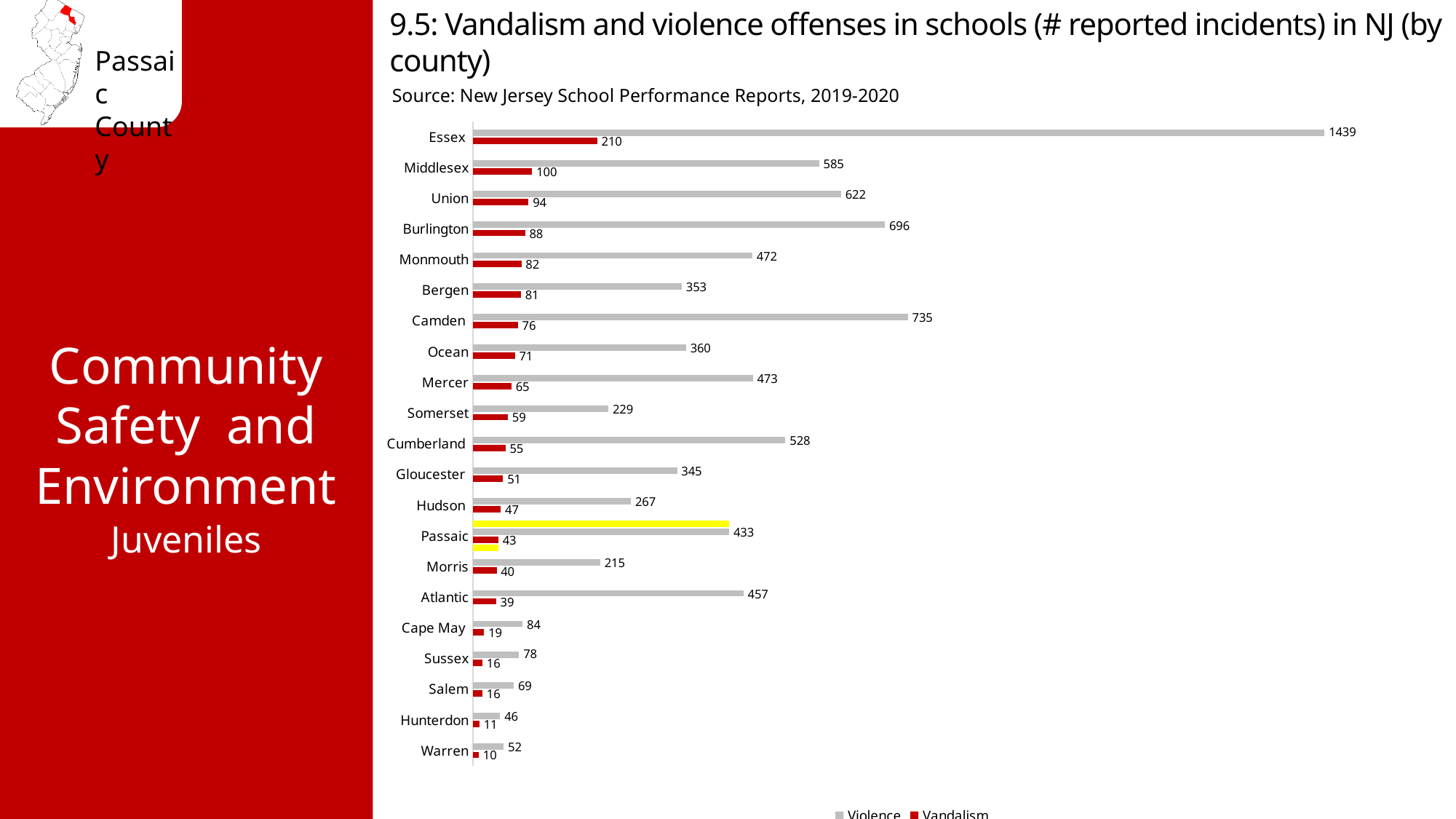
How many series does the legend list? 2 What is the difference between the violence and vandalism incident counts for Passaic county? 390 Which county has the highest number of reported violence incidents? Essex What is the number of reported violence incidents in schools for Essex county? 1439 What kind of chart is shown on the slide? Bar chart What is the number of reported vandalism incidents in schools for Passaic county? 43 How many counties are shown in the chart? 21 Which county has more reported violence incidents, Burlington or Union? Burlington Which series is shown in red in the chart? Vandalism What is the number of reported violence incidents in schools for Camden county? 735 What is the difference in vandalism incidents between Essex and Middlesex counties? 110 Which county has the lowest number of reported vandalism incidents? Warren